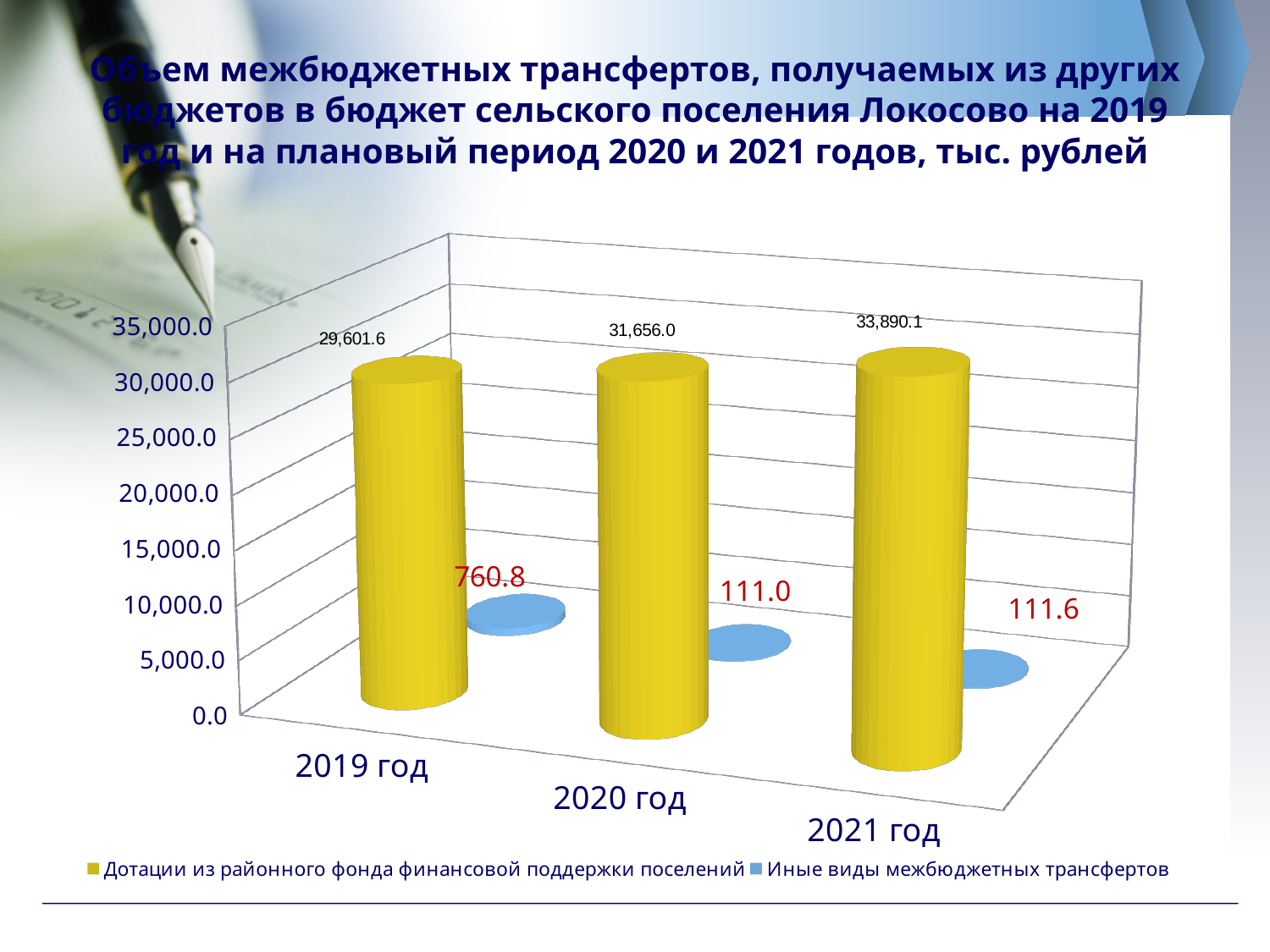
What is the difference between the Дотации values for 2021 год and 2020 год? 2,234.1 How many series does the legend list? 2 In which year is the value of Иные виды межбюджетных трансфертов lowest? 2020 год In which year is the value of Дотации из районного фонда финансовой поддержки поселений highest? 2021 год What is the value of Дотации из районного фонда финансовой поддержки поселений for 2019 год? 29,601.6 What kind of chart is shown on the slide? Bar chart What is the value of Дотации из районного фонда финансовой поддержки поселений for 2021 год? 33,890.1 Do the values of Дотации из районного фонда финансовой поддержки поселений rise or fall from 2019 год to 2021 год? Rise How many years are shown on the x axis? 3 What is the value of Иные виды межбюджетных трансфертов for 2020 год? 111.0 What is the value of Иные виды межбюджетных трансфертов for 2019 год? 760.8 Which is larger: Иные виды межбюджетных трансфертов in 2019 год or in 2021 год? 2019 год